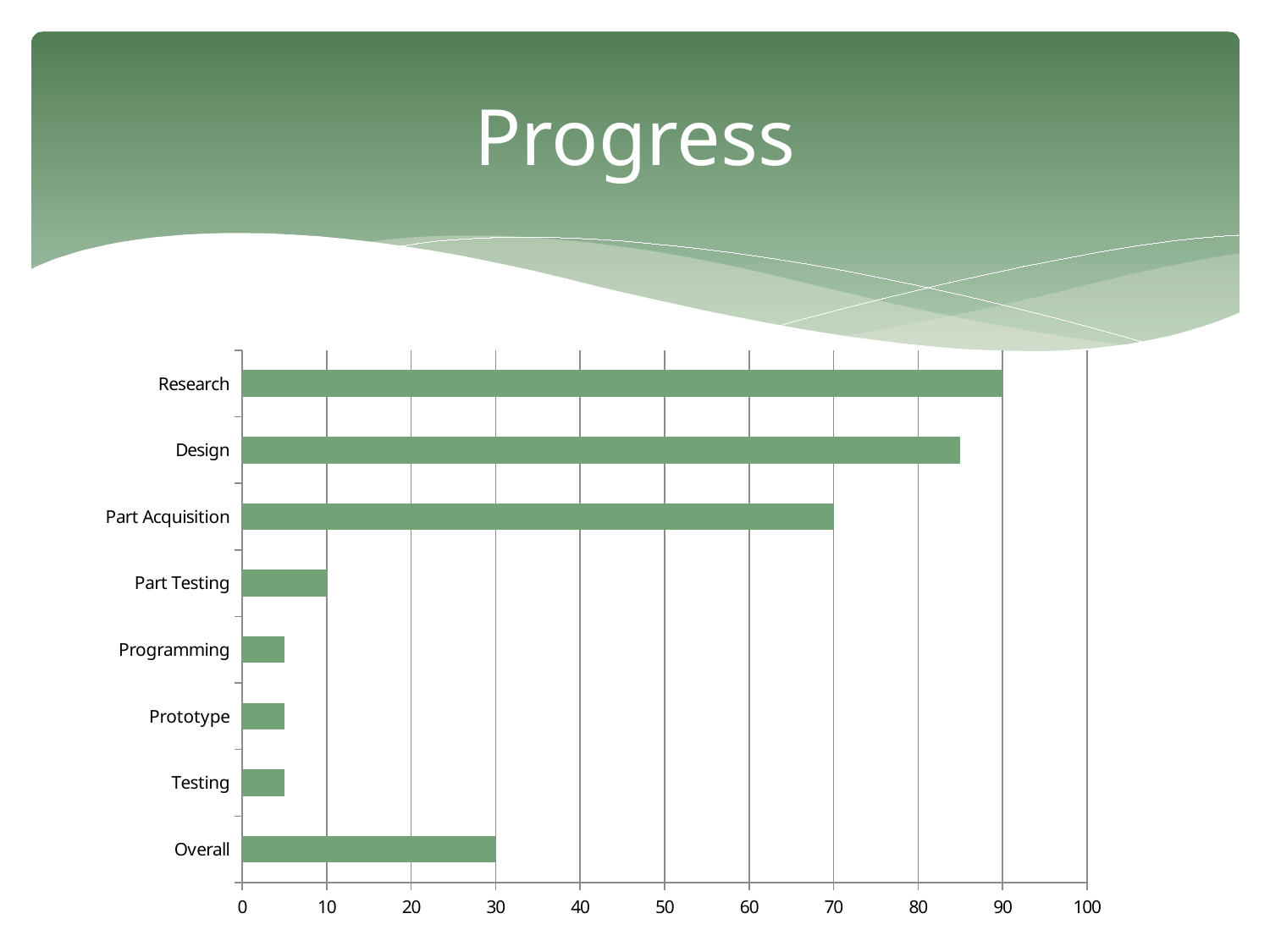
Which category has the highest value? Research Which is larger, the value for Design or the value for Part Acquisition? Design What is the value for Research? 90 Is the value for Design greater or less than 80? greater What is the difference between the values for Research and Part Acquisition? 20 What is the value for Part Testing? 10 How many categories are shown in the chart? 8 Is the value for Programming greater or less than 10? less What kind of chart is shown on the slide? bar chart What is the difference between the values for Overall and Part Testing? 20 What is the value for Overall? 30 What is the value for Part Acquisition? 70